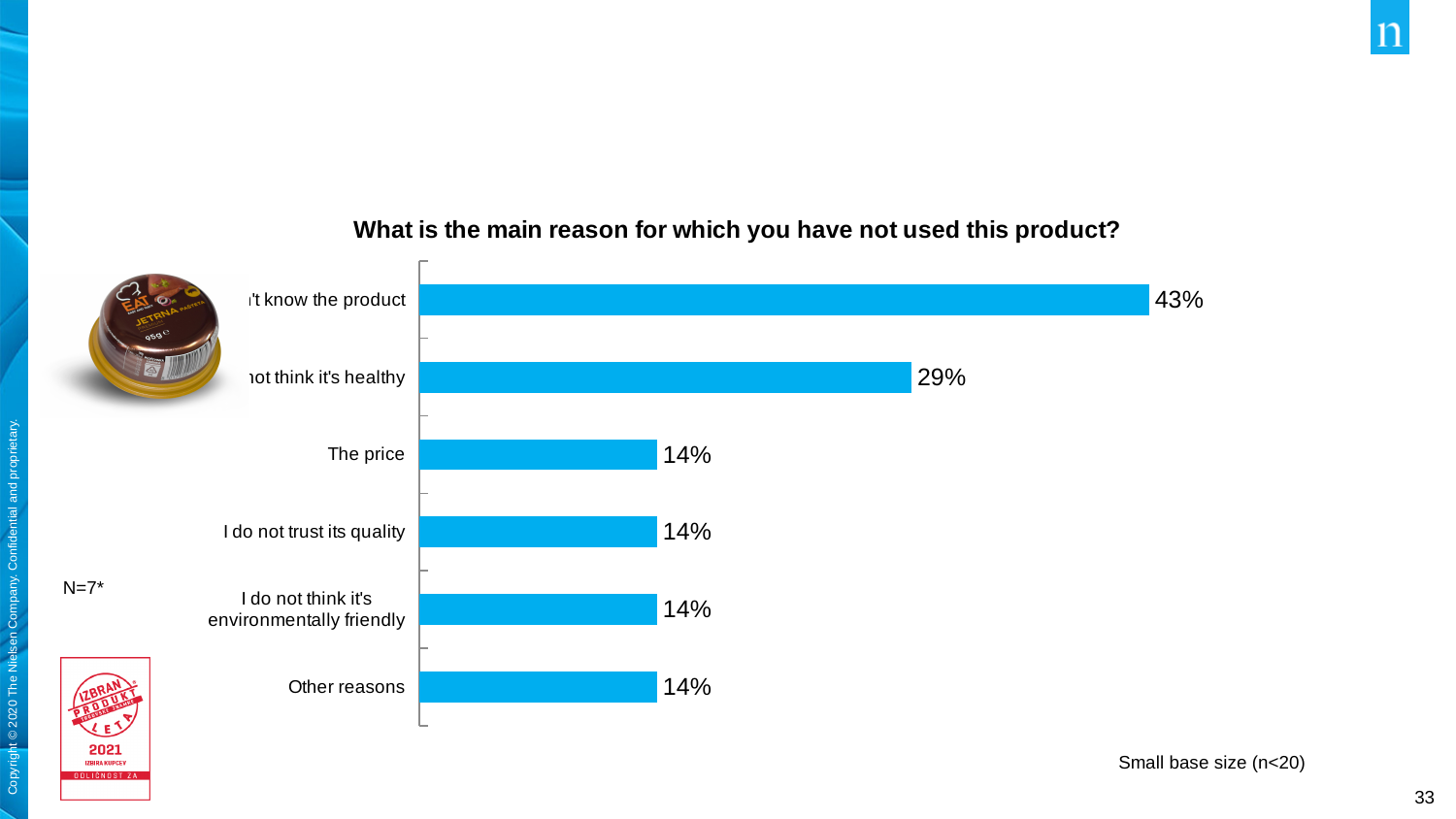
What type of chart is shown on the slide? bar chart How many categories (bars) are shown in the chart? 6 What is the value for "The price"? 14% What is the highest value shown in the chart? 43% What is the title of the chart? What is the main reason for which you have not used this product? How much larger is the largest value in the chart than the second-largest value? 14 percentage points What is the lowest value shown in the chart? 14% Is the value for "The price" larger than, smaller than, or equal to the value for "Other reasons"? equal What sample size is noted to the left of the chart? N=7* What is the value for "I do not think it's environmentally friendly"? 14% What is the value for "Other reasons"? 14% What is the value for "I do not trust its quality"? 14%